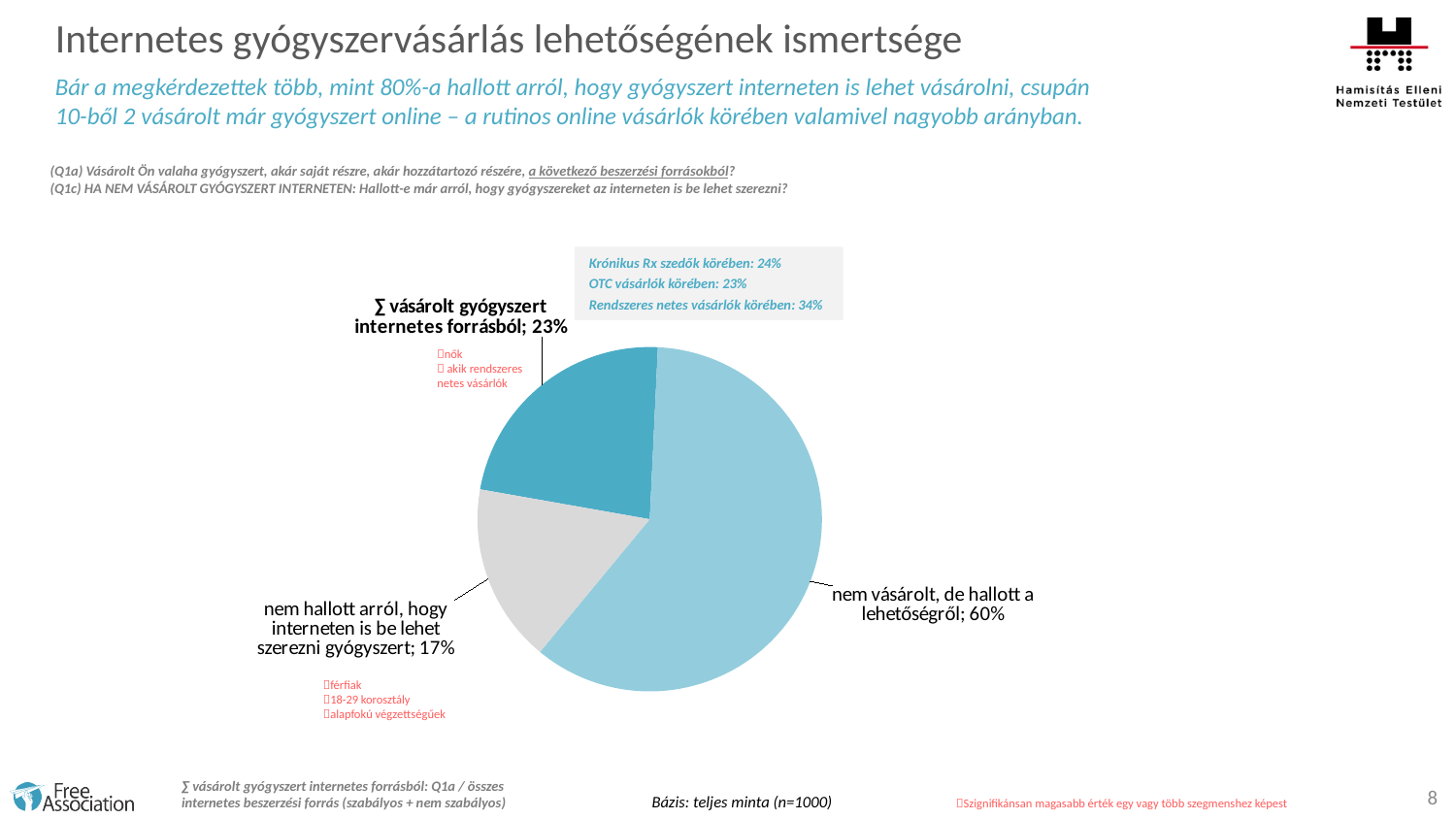
How many slices does the pie chart have? 3 What is the difference in percentage points between 'nem vásárolt, de hallott a lehetőségről' and '∑ vásárolt gyógyszert internetes forrásból'? 37 percentage points Which is larger: the share for '∑ vásárolt gyógyszert internetes forrásból' or for 'nem hallott arról, hogy interneten is be lehet szerezni gyógyszert'? ∑ vásárolt gyógyszert internetes forrásból What is the sample base (Bázis) stated on the slide? teljes minta (n=1000) Which slice of the pie chart is the smallest? nem hallott arról, hogy interneten is be lehet szerezni gyógyszert Which slice of the pie chart is the largest? nem vásárolt, de hallott a lehetőségről What share of respondents falls into the slice 'nem vásárolt, de hallott a lehetőségről'? 60% What percentage is shown for 'nem hallott arról, hogy interneten is be lehet szerezni gyógyszert'? 17% According to the callout box, what is the share of purchasers among 'Rendszeres netes vásárlók'? 34% What is the combined share of the two slices other than 'nem vásárolt, de hallott a lehetőségről'? 40% What percentage is shown for '∑ vásárolt gyógyszert internetes forrásból'? 23% What kind of chart is shown on the slide? pie chart